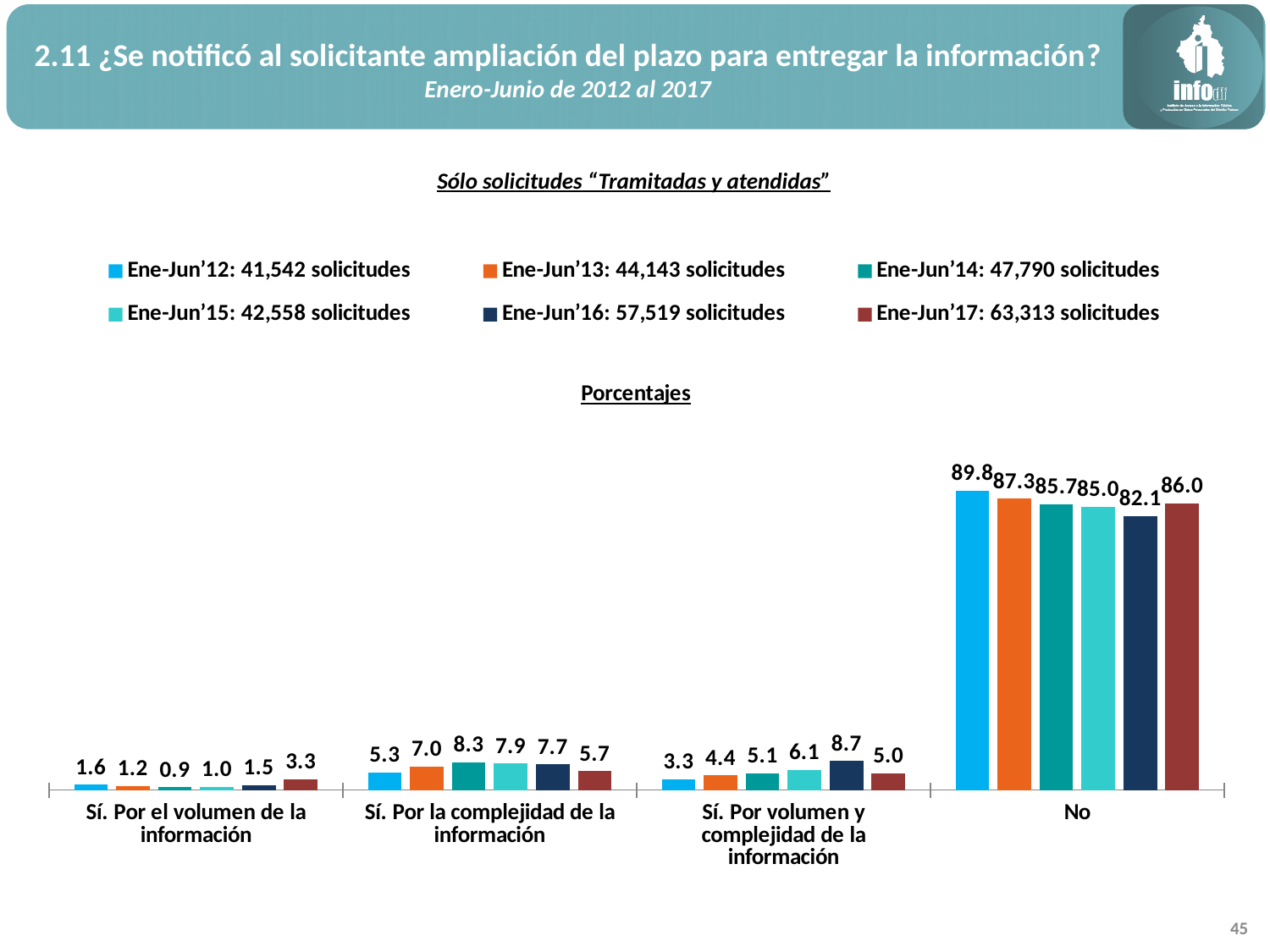
What is the value for "Sí. Por la complejidad de la información" in the Ene-Jun'14 series? 8.3 How many series does the legend list? 6 What is the value for "No" in the Ene-Jun'12 series? 89.8 What kind of chart is shown on the slide? Bar chart What is the value for "Sí. Por volumen y complejidad de la información" in the Ene-Jun'16 series? 8.7 What is the value for "Sí. Por el volumen de la información" in the Ene-Jun'17 series? 3.3 What is the difference between the Ene-Jun'12 and Ene-Jun'16 values for "No"? 7.7 How many categories are shown on the x axis? 4 Which series has the lowest value for "Sí. Por el volumen de la información"? Ene-Jun'14 Which is larger for "Sí. Por la complejidad de la información": the Ene-Jun'13 value or the Ene-Jun'17 value? Ene-Jun'13 Which series has the highest value for "No"? Ene-Jun'12 According to the legend, how many solicitudes does the Ene-Jun'17 series represent? 63,313 solicitudes